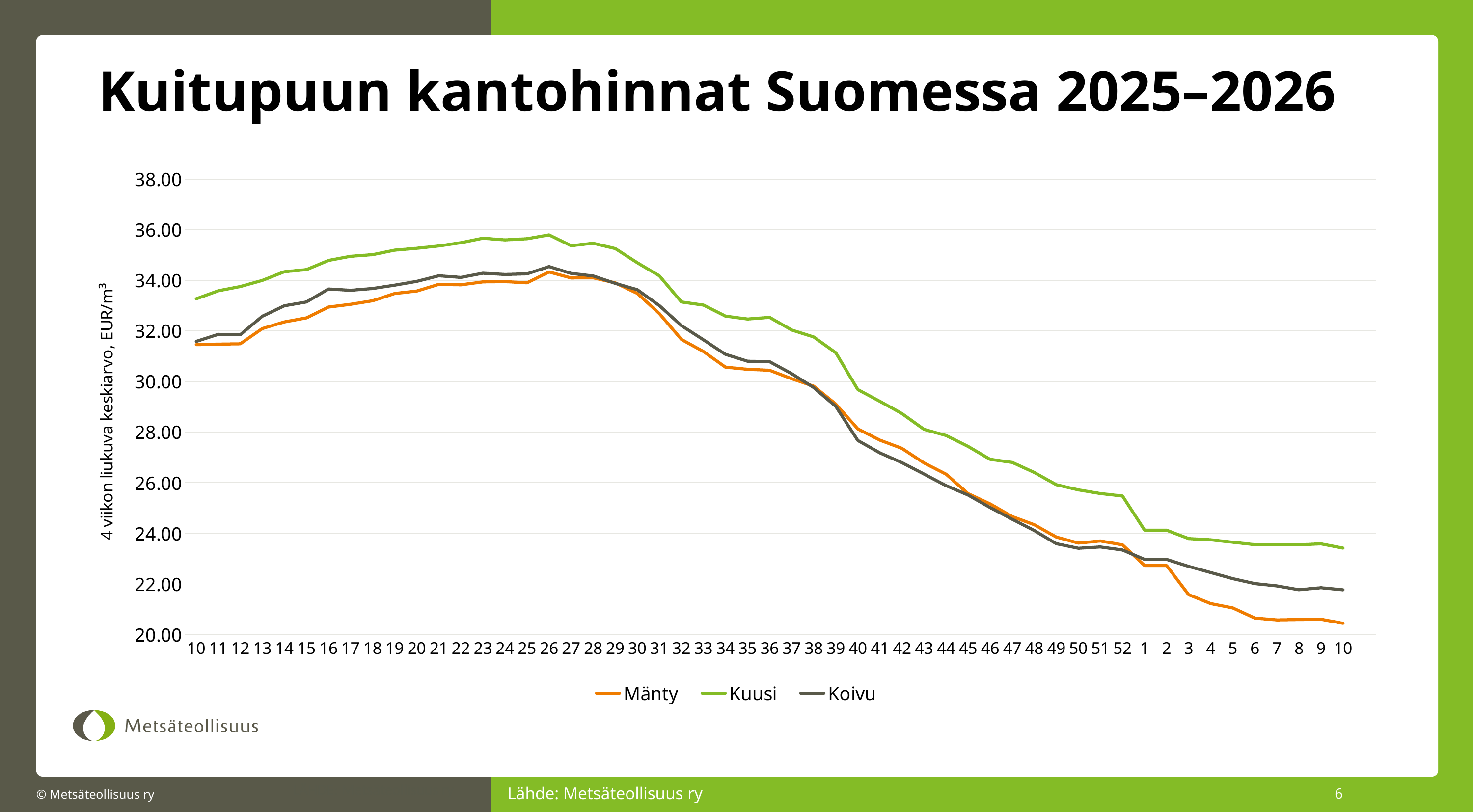
Is the value for Mänty at week 10 (the first point) greater or less than 32.00? less What is the label of the vertical axis? 4 viikon liukuva keskiarvo, EUR/m³ Which series has the highest value at week 26? Kuusi Is the value for Mänty at the last point (week 10) greater or less than 22.00? less Which series are listed in the legend? Mänty, Kuusi, Koivu Is the value for Kuusi at week 26 greater or less than 34.00? greater How many points are on the x axis? 53 Which series has the lowest value at the last point (week 10)? Mänty Do the values for Kuusi rise or fall from week 30 to week 52? fall How many series does the legend list? 3 What kind of chart is shown on the slide? line chart